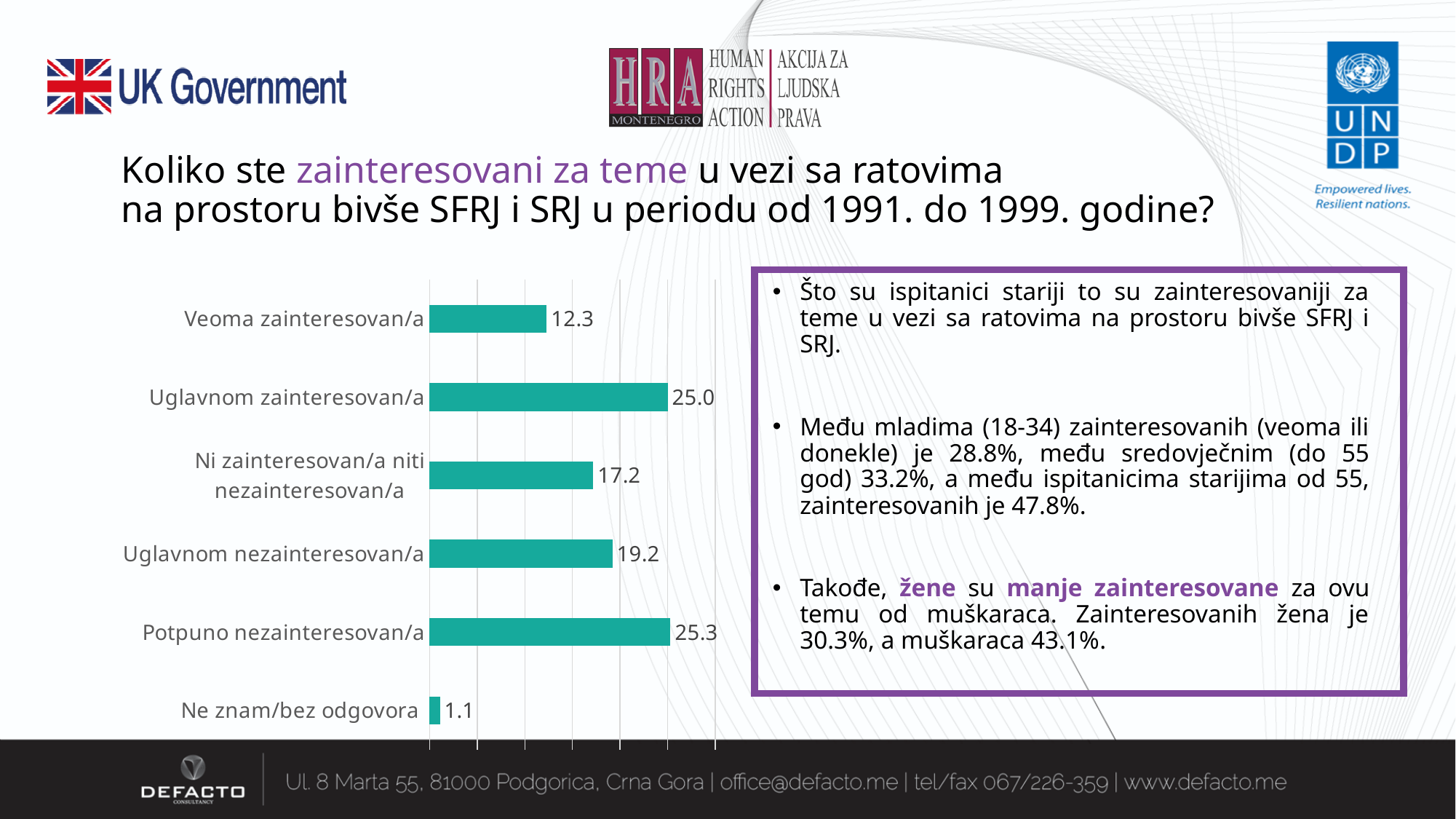
Which category has the lowest value? Ne znam/bez odgovora Which category has the highest value? Potpuno nezainteresovan/a What is the value for "Ne znam/bez odgovora"? 1.1 What is the value for "Uglavnom zainteresovan/a"? 25.0 What is the difference between the values for "Uglavnom zainteresovan/a" and "Veoma zainteresovan/a"? 12.7 What is the value for "Uglavnom nezainteresovan/a"? 19.2 How many categories are shown in the chart? 6 What kind of chart is shown on the slide? bar chart Which is larger, the value for "Uglavnom nezainteresovan/a" or the value for "Ni zainteresovan/a niti nezainteresovan/a"? Uglavnom nezainteresovan/a What is the value for "Veoma zainteresovan/a"? 12.3 What is the value for "Potpuno nezainteresovan/a"? 25.3 What is the value for "Ni zainteresovan/a niti nezainteresovan/a"? 17.2